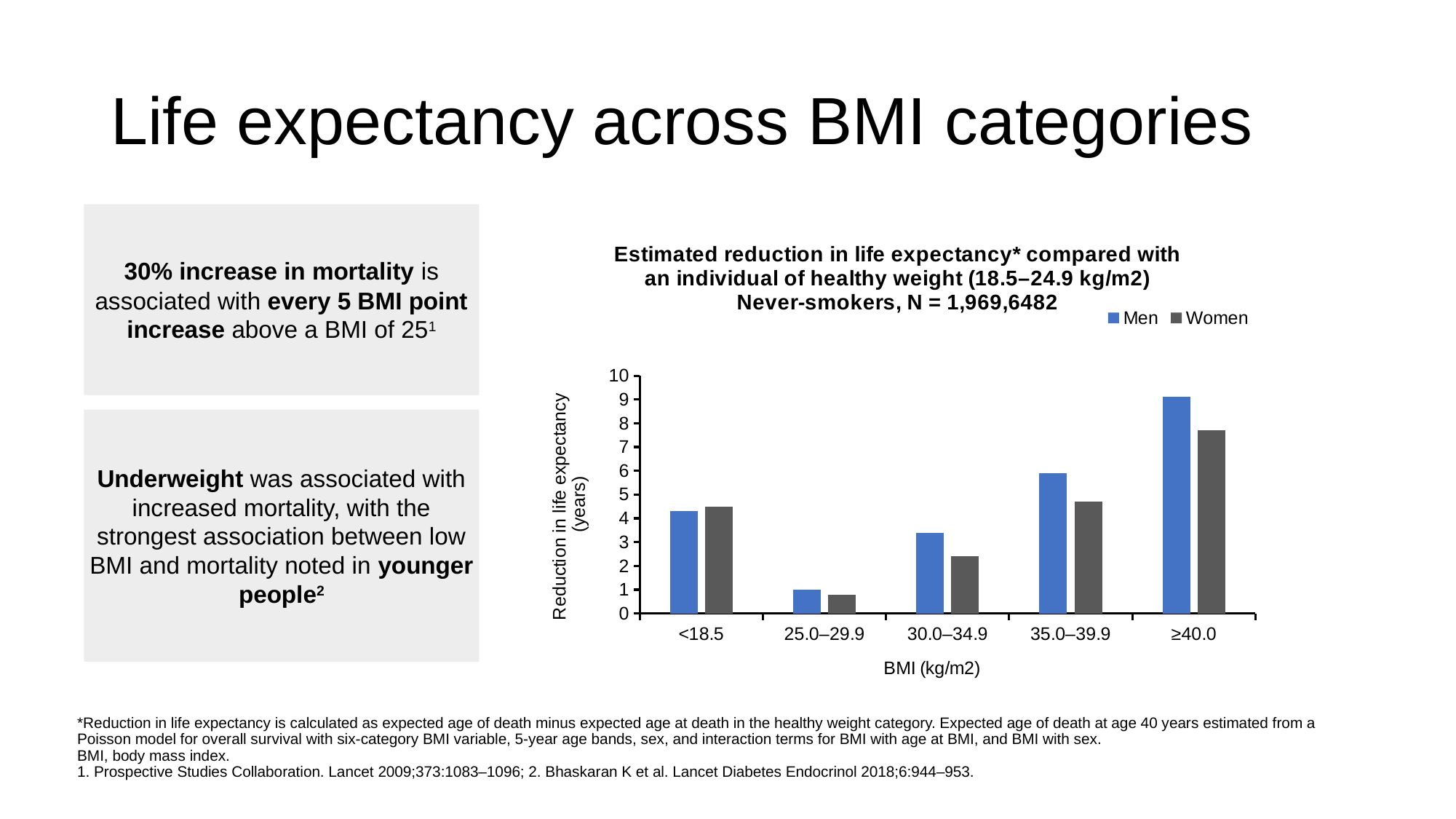
Is the reduction in life expectancy for Men in the ≥40.0 BMI category greater or less than 8 years? greater How many series does the chart legend list? 2 Which colour represents the Women series in the chart? grey How many BMI categories are shown on the x axis of the chart? 5 In the ≥40.0 BMI category, which series shows the larger reduction in life expectancy, Men or Women? Men Which BMI category has the highest reduction in life expectancy for Men? ≥40.0 Is the reduction in life expectancy for Men in the 35.0–39.9 BMI category greater or less than 5 years? greater Is the reduction in life expectancy for Women in the 30.0–34.9 BMI category greater or less than 3 years? less Which BMI category has the lowest reduction in life expectancy for Women? 25.0–29.9 In the 30.0–34.9 BMI category, which series shows the larger reduction in life expectancy, Men or Women? Men What is the label of the x axis of the chart? BMI (kg/m2) What kind of chart is shown on the slide? bar chart